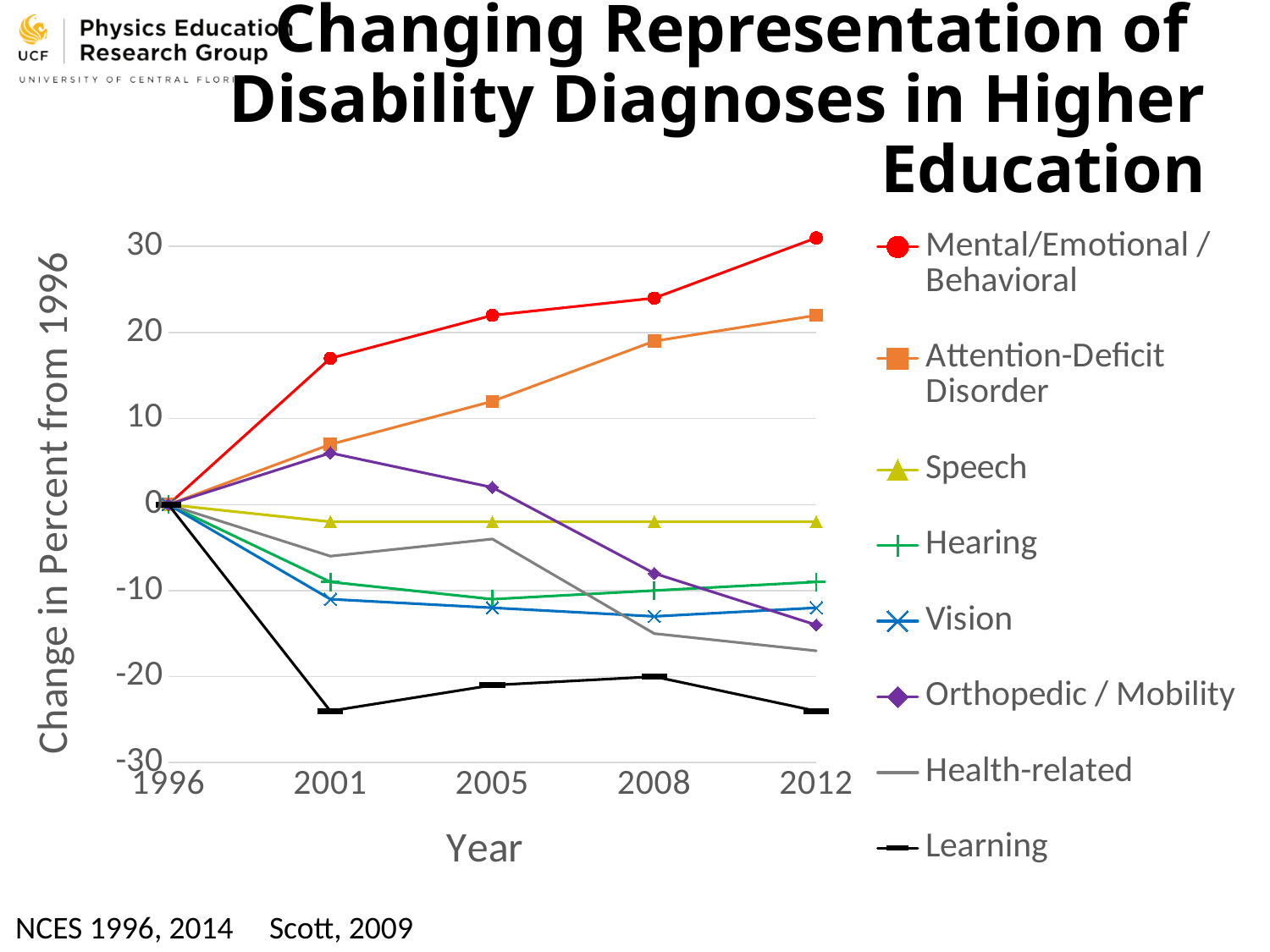
Is the value for Orthopedic / Mobility in 2001 greater or less than 0? greater Is the value for Mental/Emotional / Behavioral in 2012 greater or less than 20? greater Which series has the highest value in 2012? Mental/Emotional / Behavioral How many years are plotted along the x axis? 5 What kind of chart is shown on the slide? line chart Which series has the lowest value in 2012? Learning What is the label of the y axis? Change in Percent from 1996 In 2005, which is larger: Mental/Emotional / Behavioral or Attention-Deficit Disorder? Mental/Emotional / Behavioral How many series does the legend list? 8 Does the Attention-Deficit Disorder series rise or fall from 1996 to 2012? rise Is the value for Health-related in 2012 greater or less than -10? less